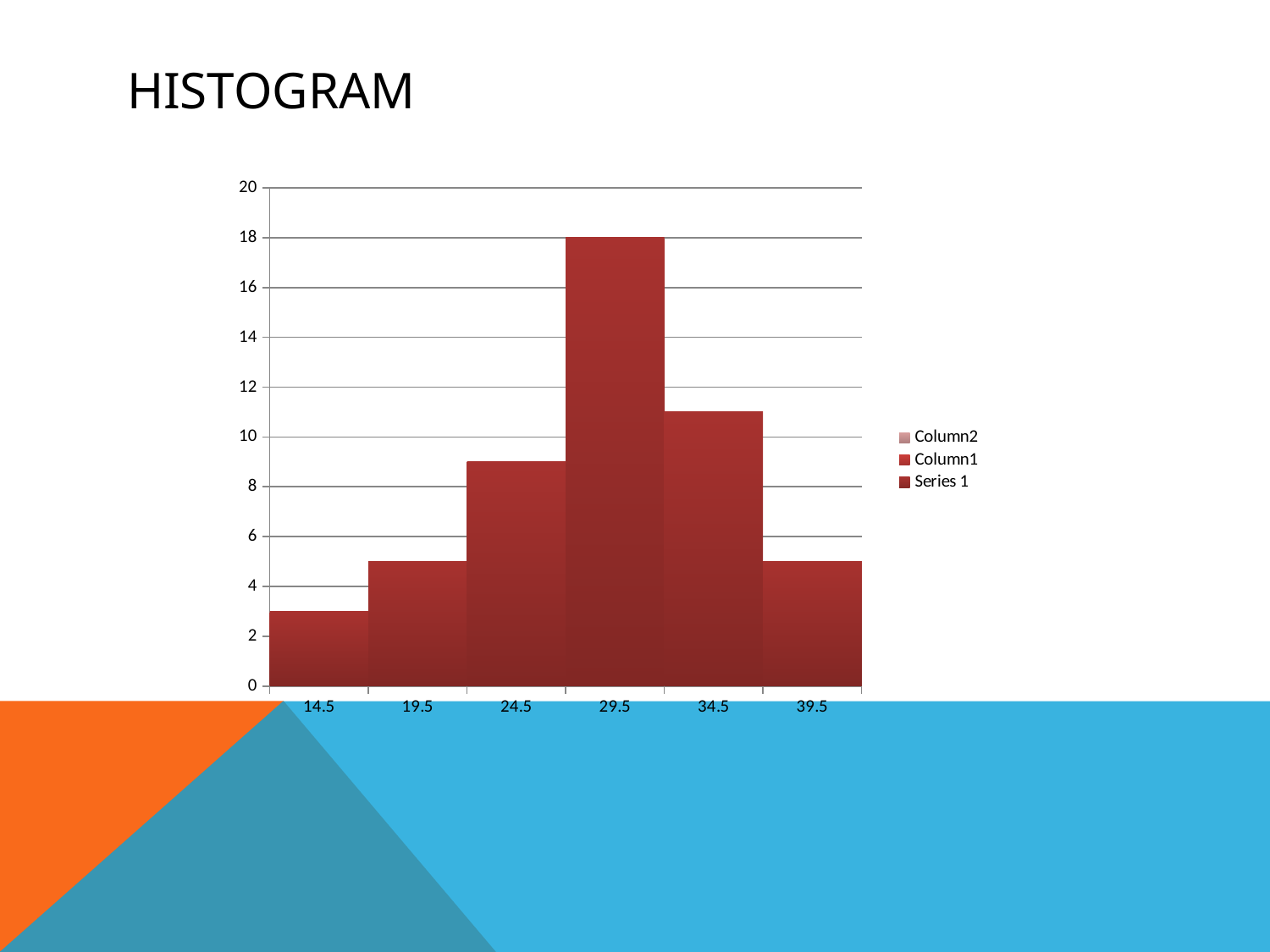
What is the value of the bar at 29.5? 18 Which category has the highest bar? 29.5 What kind of chart is shown on the slide? bar chart Is the value for 19.5 greater or less than 6? less How many categories are shown on the x axis of the chart? 6 How many series does the chart's legend list? 3 What are the entries listed in the chart's legend? Column2, Column1, Series 1 Which category has the lowest bar? 14.5 Is the value for 14.5 greater or less than 4? less Is the value for 24.5 greater or less than 8? greater Which has the larger value, 24.5 or 34.5? 34.5